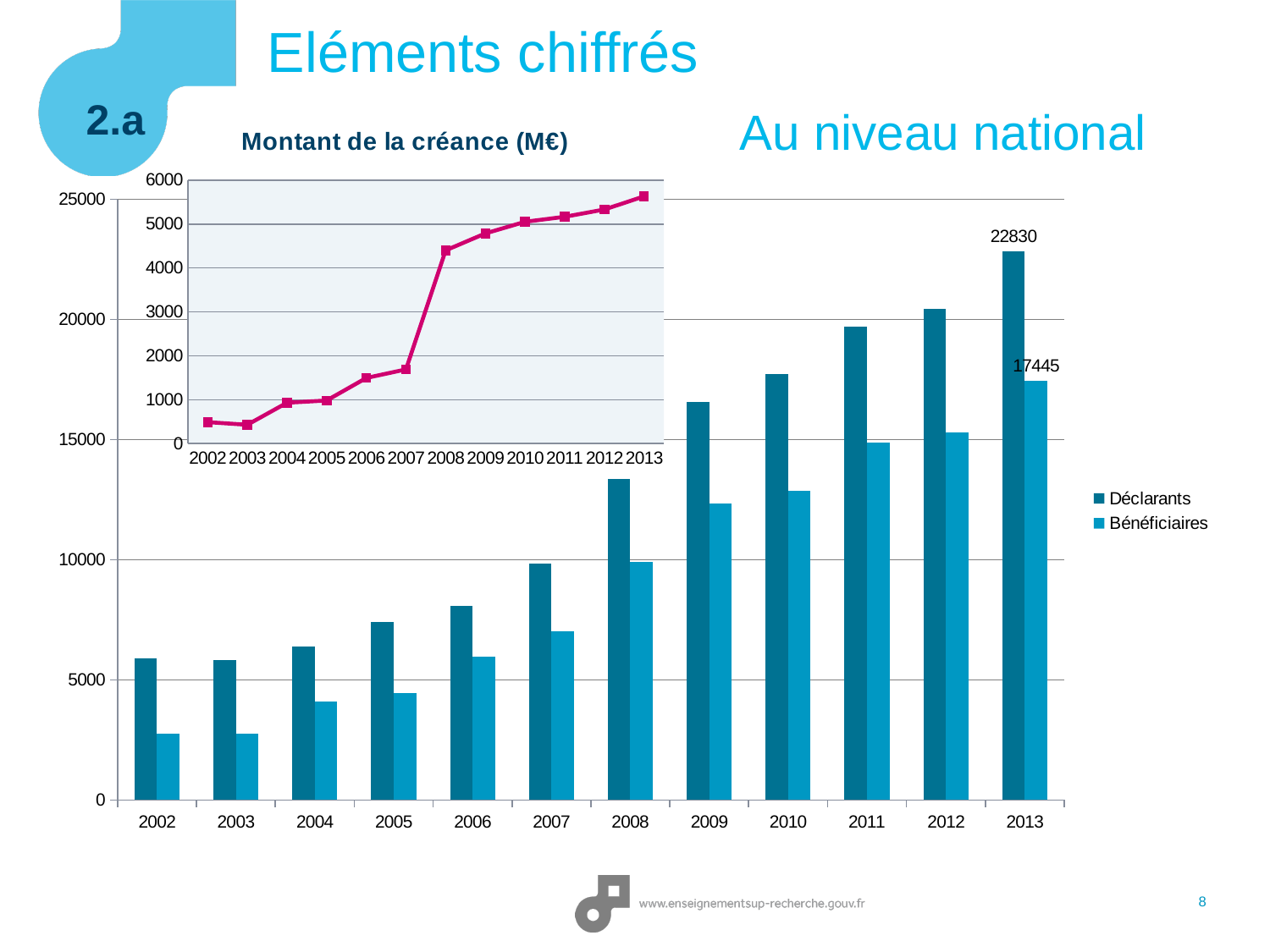
In the chart 'Montant de la créance (M€)', is the value for 2008 greater or less than 4000? greater In the bar chart, how many series does the legend list? 2 In the bar chart, which year has the highest value for Déclarants? 2013 In the chart 'Montant de la créance (M€)', which year has the highest value? 2013 What kind of chart is the inset chart titled 'Montant de la créance (M€)'? line chart In the bar chart, what is the value for Bénéficiaires in 2013? 17445 In the bar chart, what is the difference between Déclarants and Bénéficiaires in 2013? 5385 In the bar chart, is the value for Bénéficiaires in 2010 greater or less than 10000? greater In the bar chart, do the Déclarants values generally rise or fall from 2002 to 2013? rise In the bar chart, what is the value for Déclarants in 2013? 22830 In the bar chart, is the value for Déclarants in 2008 greater or less than 10000? greater In the bar chart, how many years are shown on the x axis? 12